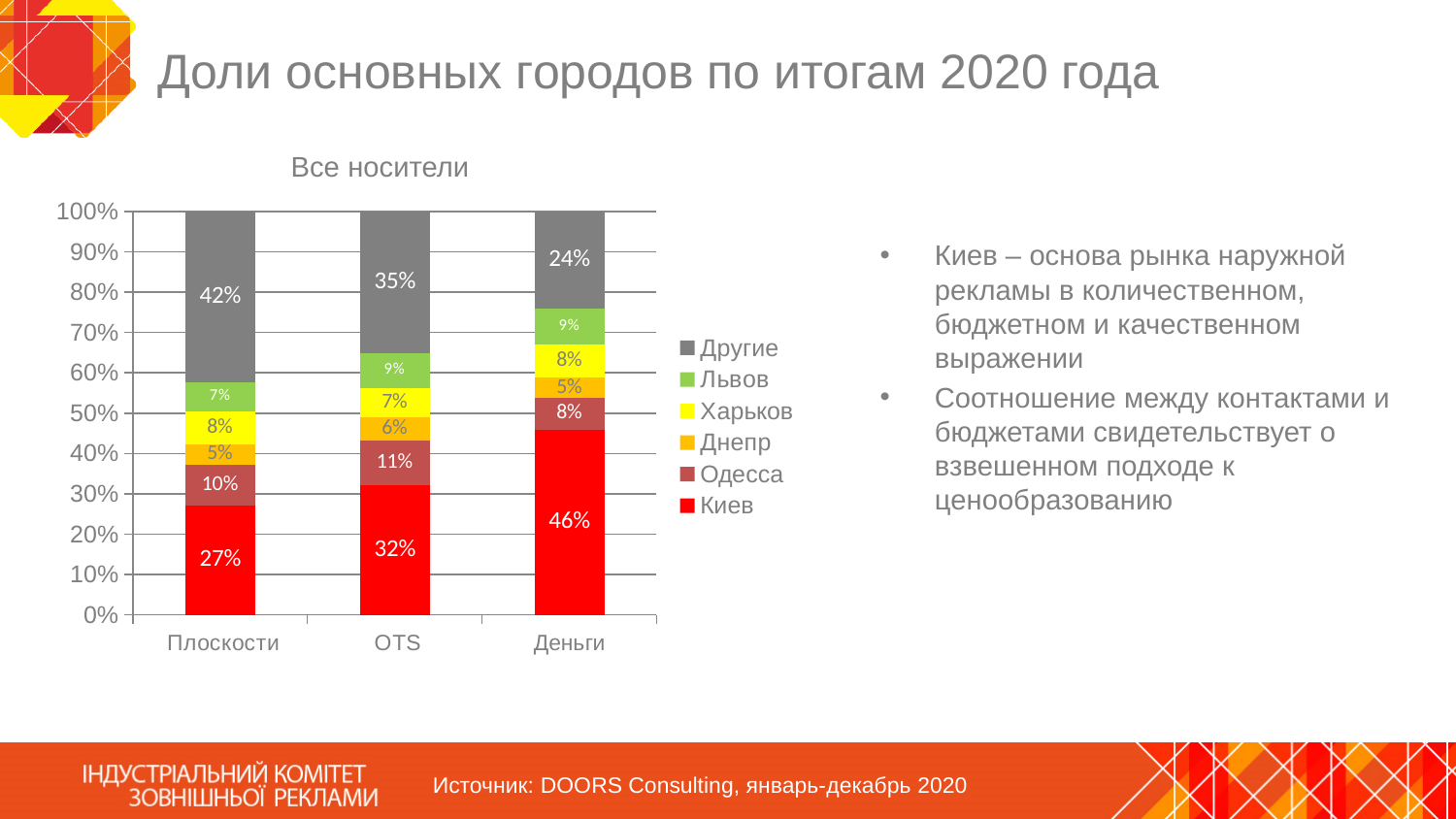
What is the value for Одесса in the OTS bar? 11% In which category does Другие have the lowest share? Деньги What kind of chart is shown on the slide? Stacked bar chart How many series does the legend list? 6 What is the value for Киев in the Деньги bar? 46% Does the Киев share rise or fall going from Плоскости to OTS to Деньги? Rises What is the value for Другие in the Плоскости bar? 42% In which category does Киев have the highest share? Деньги What is the value for Днепр in the Плоскости bar? 5% How many categories are shown on the x axis? 3 In the OTS bar, which is larger: Львов or Харьков? Львов What is the difference between the Киев share in Деньги and the Киев share in Плоскости? 19%